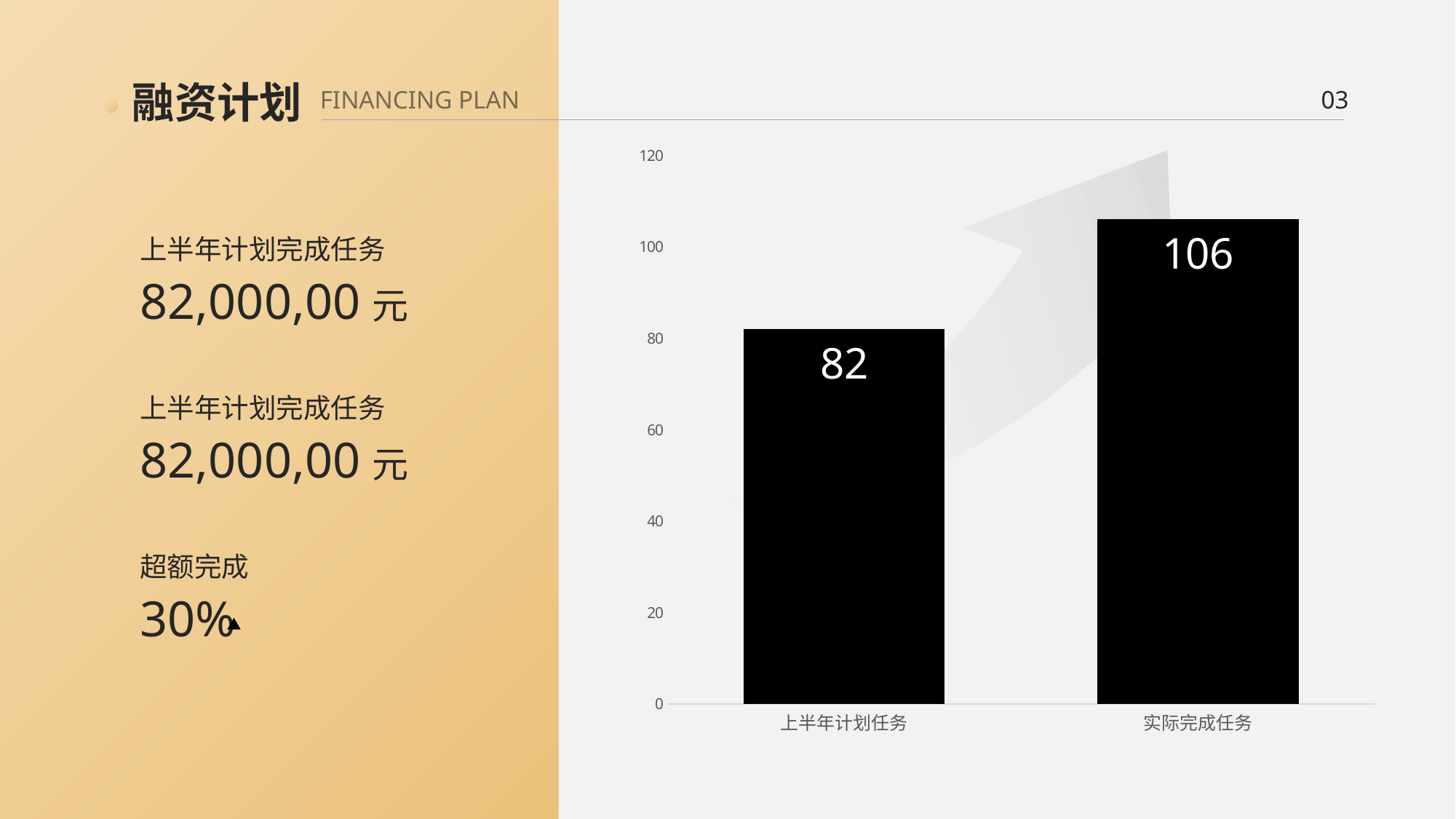
What is the value for 实际完成任务? 106 Do the values rise or fall from left to right along the x axis? rise Which is larger, the value for 上半年计划任务 or the value for 实际完成任务? 实际完成任务 Which category has the lowest value? 上半年计划任务 Is the value for 实际完成任务 greater or less than 100? greater What is the difference between the values for 实际完成任务 and 上半年计划任务? 24 Is the value for 上半年计划任务 greater or less than 100? less How many categories are shown on the x axis of the chart? 2 Which category has the highest value? 实际完成任务 What kind of chart is shown on the slide? bar chart What is the highest tick value shown on the vertical axis of the chart? 120 What is the value for 上半年计划任务? 82